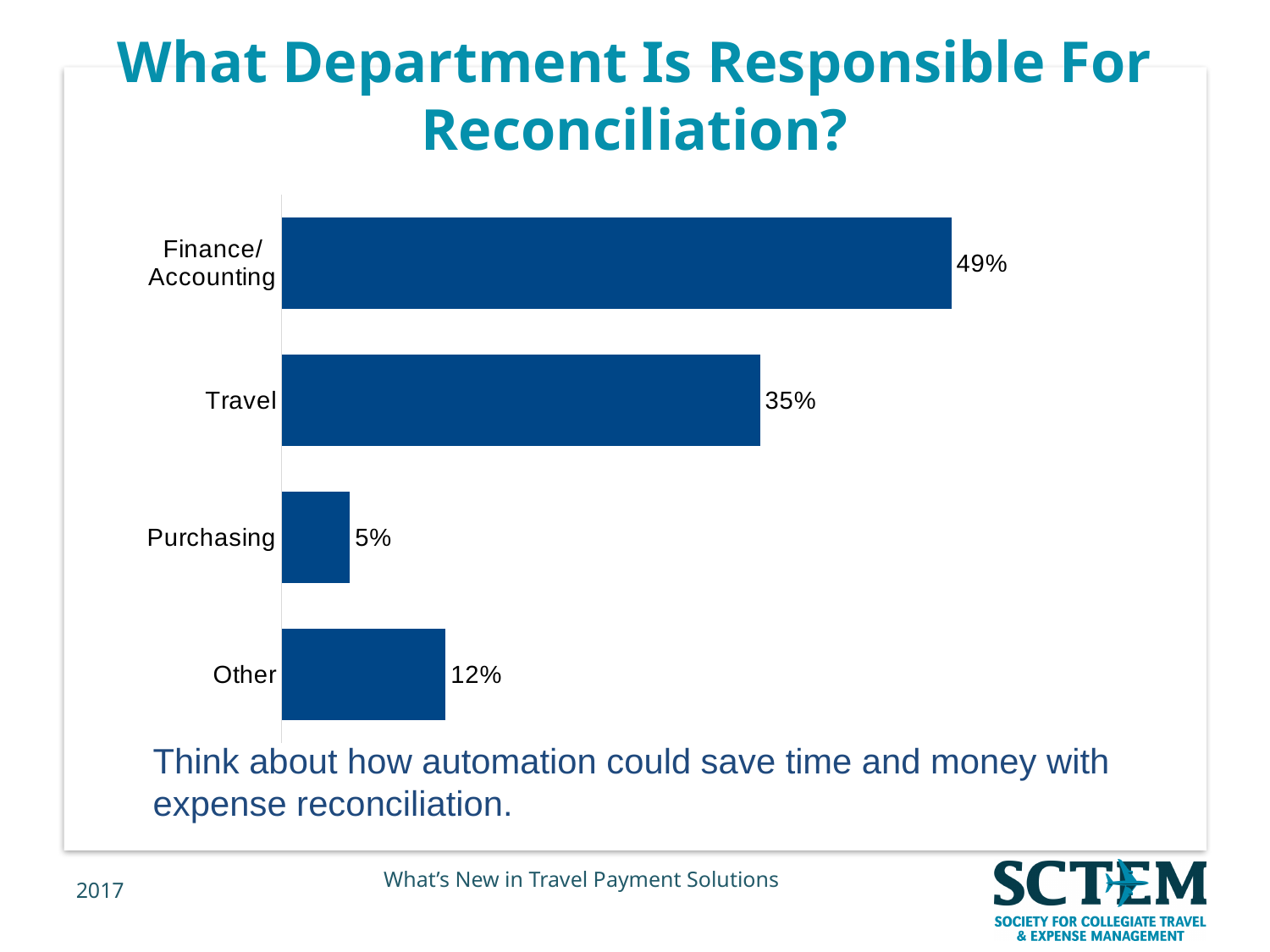
Which category has the lowest percentage? Purchasing What percentage is shown for Finance/Accounting? 49% What percentage is shown for Other? 12% What percentage is shown for Travel? 35% Which department has the highest percentage? Finance/Accounting How many categories are shown in the chart? 4 What percentage is shown for Purchasing? 5% What kind of chart is shown on the slide? Bar chart What is the difference between the Finance/Accounting and Travel percentages? 14% What is the title of the chart on the slide? What Department Is Responsible For Reconciliation? What is the difference between the Other and Purchasing percentages? 7% Which is larger, the value for Travel or the value for Other? Travel